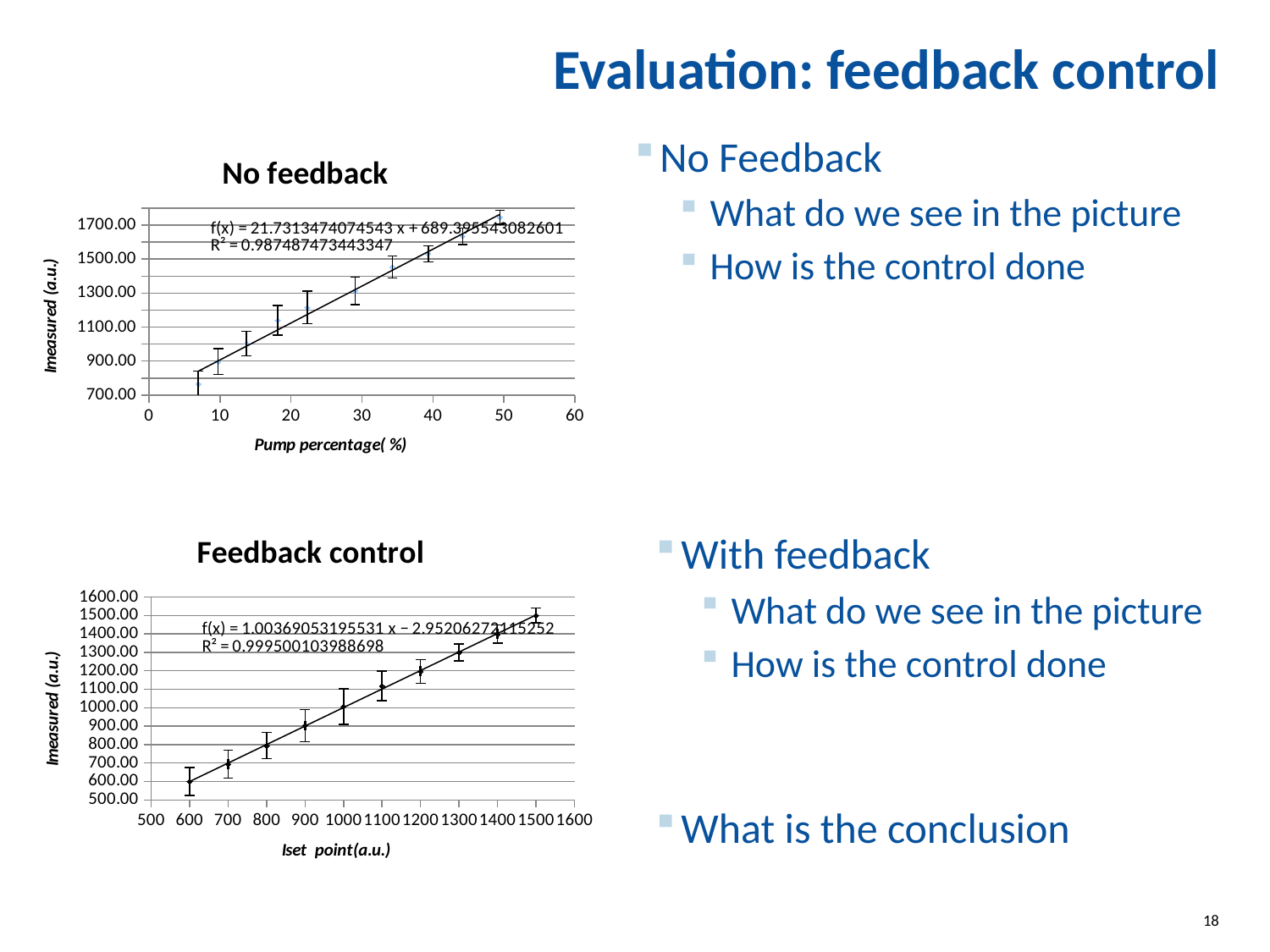
In the 'No feedback' chart, is the measured value at a pump percentage of 50 greater or less than 1500? greater In the 'Feedback control' chart, at which set point is the measured value highest? 1500 In the 'No feedback' chart, is the measured value at a pump percentage of 10 greater or less than 1100? less In the 'Feedback control' chart, what is the R² value shown for the trendline? 0.999500103988698 How many data points are plotted in the 'Feedback control' chart? 10 In the 'Feedback control' chart, which has the larger measured value: set point 1500 or set point 600? 1500 In the 'Feedback control' chart, do the measured values rise or fall as the set point increases? rise In the 'No feedback' chart, do the measured values rise or fall as the pump percentage increases? rise What is the x-axis label of the 'No feedback' chart? Pump percentage( %) In the 'Feedback control' chart, is the measured value at a set point of 600 greater or less than 700? less In the 'No feedback' chart, what is the R² value shown for the trendline? 0.987487473443347 What kind of chart is the 'No feedback' chart? scatter chart